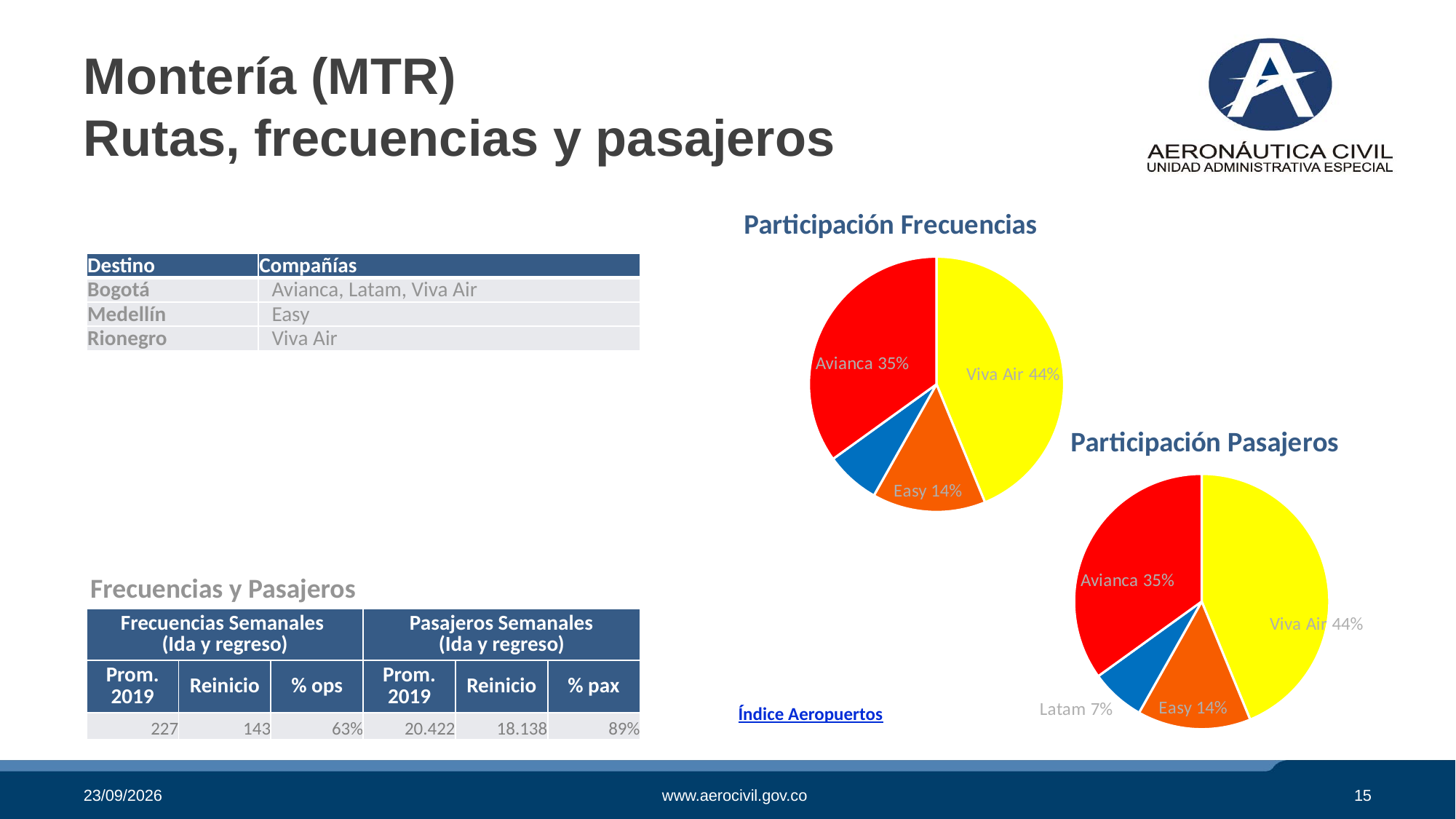
In the "Participación Pasajeros" chart, which is larger, Avianca's share or Easy's share? Avianca In the "Participación Pasajeros" chart, which airline has the smallest slice? Latam In the "Participación Frecuencias" chart, what share does Viva Air have? 44% In the "Participación Pasajeros" chart, what share does Latam have? 7% What type of chart is "Participación Frecuencias"? Pie chart In the "Participación Frecuencias" chart, what share does Avianca have? 35% In the "Participación Frecuencias" chart, how many percentage points larger is Viva Air's share than Avianca's? 9 How many slices does the "Participación Pasajeros" pie chart have? 4 In the "Participación Pasajeros" chart, what colour is the Viva Air slice? Yellow In the "Participación Frecuencias" chart, which airline has the largest slice? Viva Air